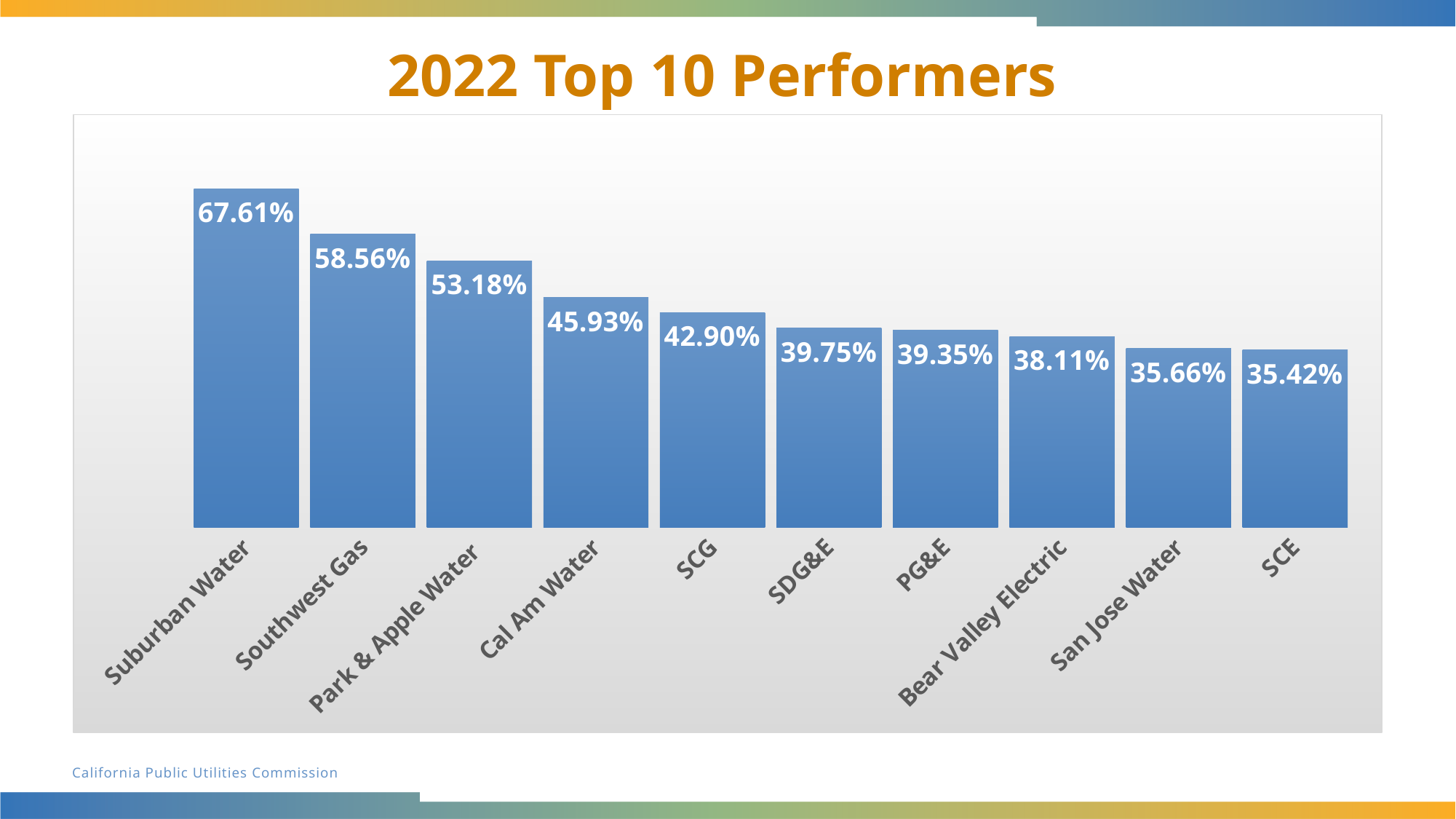
What is the value for SCG? 42.90% What is the value for Suburban Water? 67.61% What is the value for Bear Valley Electric? 38.11% Which is larger, the value for Park & Apple Water or the value for Cal Am Water? Park & Apple Water Do the values rise or fall from left to right along the x axis? fall What is the title of the chart? 2022 Top 10 Performers Which category has the lowest value? SCE What is the difference between the values for Cal Am Water and SCG? 3.03% Which category has the highest value? Suburban Water How many categories are shown in the chart? 10 What kind of chart is shown on the slide? bar chart What is the difference between the values for Suburban Water and Southwest Gas? 9.05%